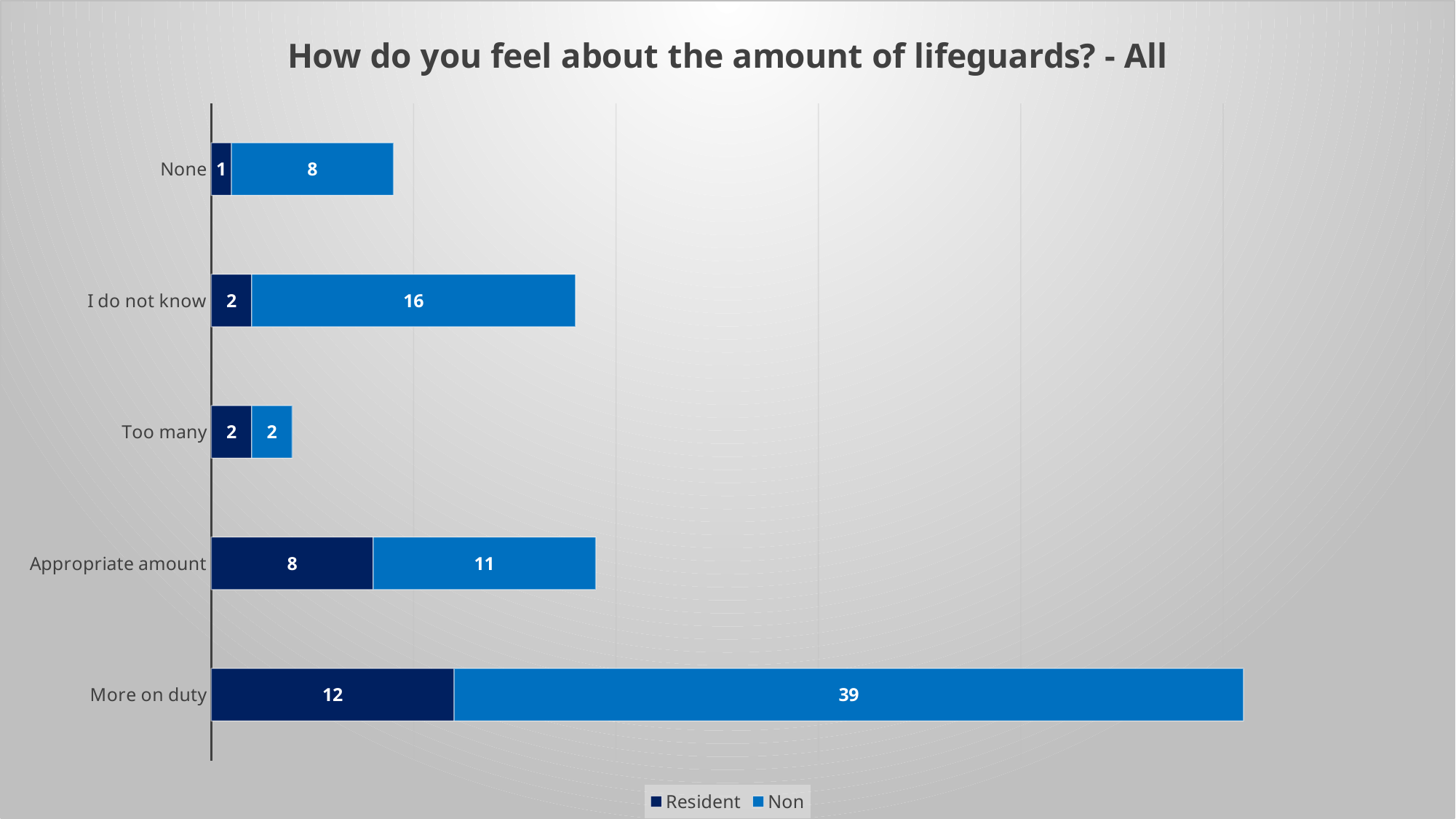
How many categories are shown on the chart? 5 What is the total of the stacked bar for "I do not know"? 18 What is the Resident value for "Appropriate amount"? 8 What is the Non value for "More on duty"? 39 What is the Non value for "I do not know"? 16 What is the total of the stacked bar for "More on duty"? 51 What is the difference between the Non and Resident values for "More on duty"? 27 Which category has the lowest Resident value? None What kind of chart is shown? Stacked bar chart How many series does the legend list? 2 Which category has the highest Non value? More on duty Which is larger for "Appropriate amount": the Resident value or the Non value? Non